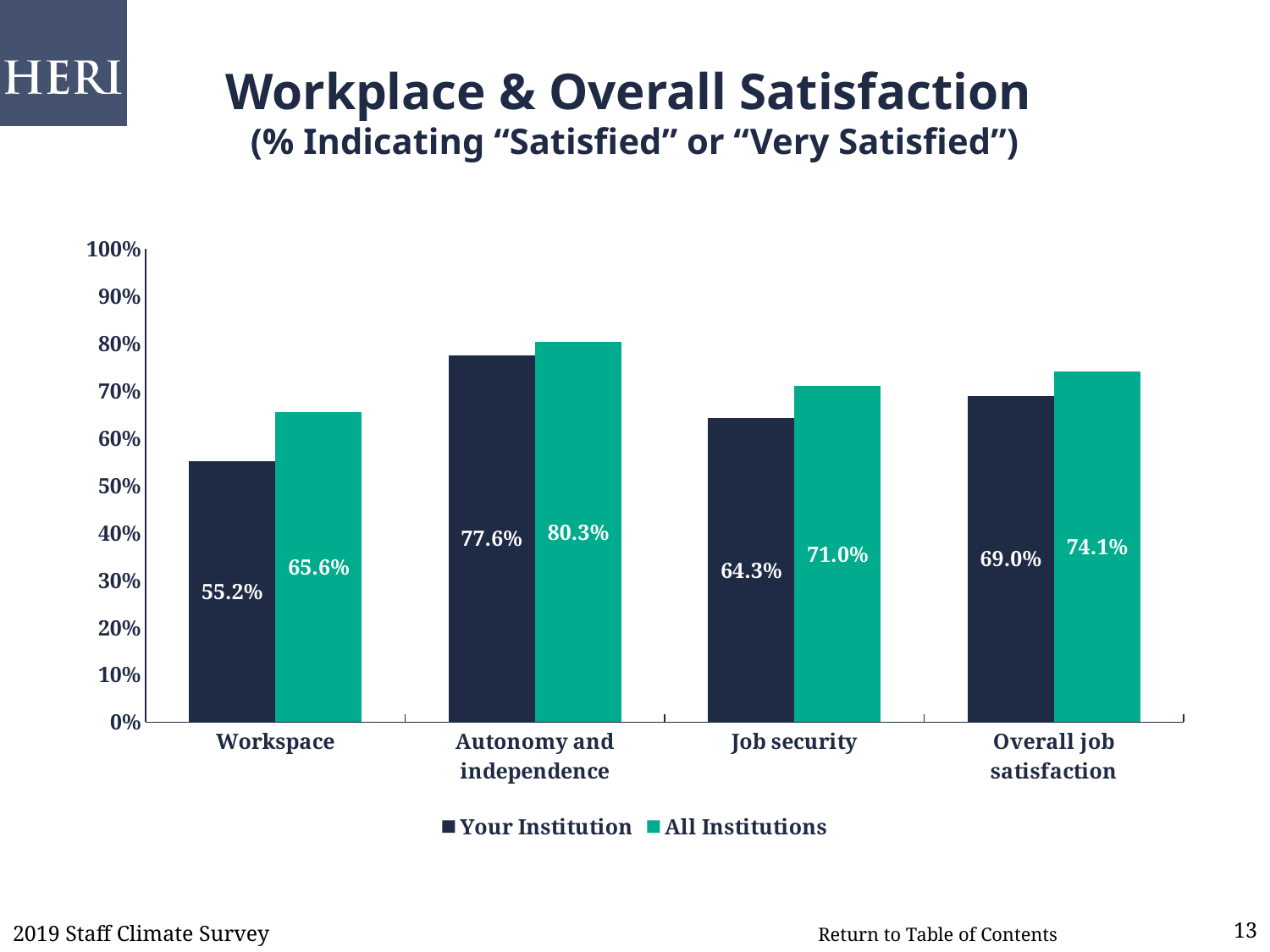
What is the value for Your Institution for Job security? 64.3% Is the value for Your Institution for Overall job satisfaction greater or less than 60%? greater What is the value for All Institutions for Overall job satisfaction? 74.1% What kind of chart is shown on the slide? Bar chart How many categories are shown on the x axis? 4 How many series does the legend list? 2 Which category has the highest value for Your Institution? Autonomy and independence Which is larger for Job security: Your Institution or All Institutions? All Institutions Which category has the lowest value for All Institutions? Workspace What is the value for Your Institution for Workspace? 55.2% What is the value for All Institutions for Autonomy and independence? 80.3% What is the difference between All Institutions and Your Institution for Workspace? 10.4%